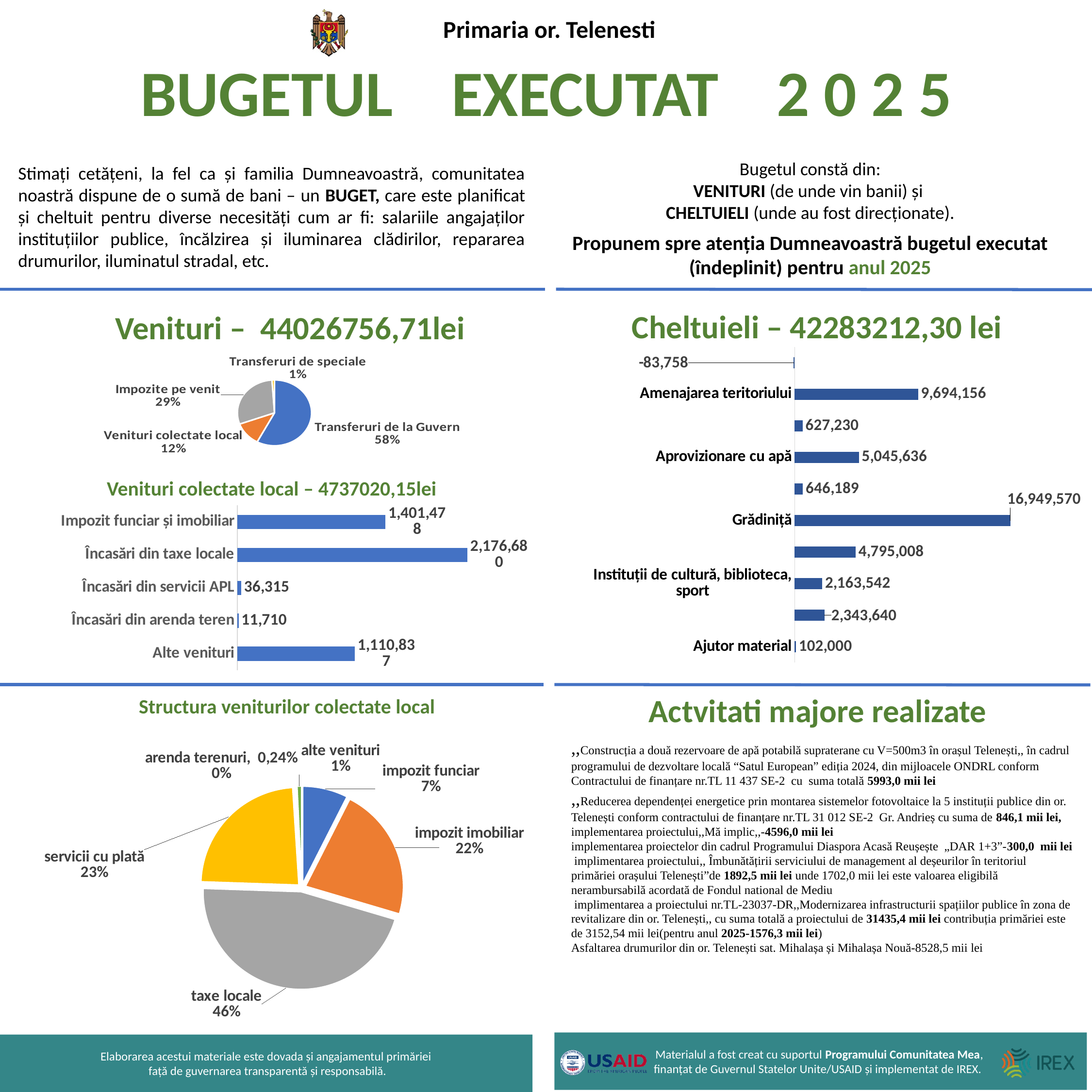
In the 'Venituri colectate local' bar chart, which category has the lowest value? Încasări din arenda teren What kind of chart is the 'Cheltuieli' chart? Bar chart In the 'Venituri colectate local' bar chart, what is the difference between 'Încasări din taxe locale' and 'Impozit funciar și imobiliar'? 775,202 How many categories are shown in the 'Venituri colectate local' bar chart? 5 In the 'Structura veniturilor colectate local' pie chart, what share does 'taxe locale' have? 46% In the 'Venituri' pie chart, which category has the largest slice? Transferuri de la Guvern In the 'Venituri' pie chart, what share does 'Transferuri de la Guvern' have? 58% In the 'Cheltuieli' bar chart, what is the value for 'Grădiniță'? 16,949,570 In the 'Cheltuieli' bar chart, which category has the highest value? Grădiniță In the 'Venituri colectate local' bar chart, what is the value for 'Încasări din taxe locale'? 2,176,680 In the 'Cheltuieli' bar chart, which is larger: 'Amenajarea teritoriului' or 'Aprovizionare cu apă'? Amenajarea teritoriului In the 'Structura veniturilor colectate local' pie chart, what is the difference between the shares of 'servicii cu plată' and 'impozit funciar'? 16%